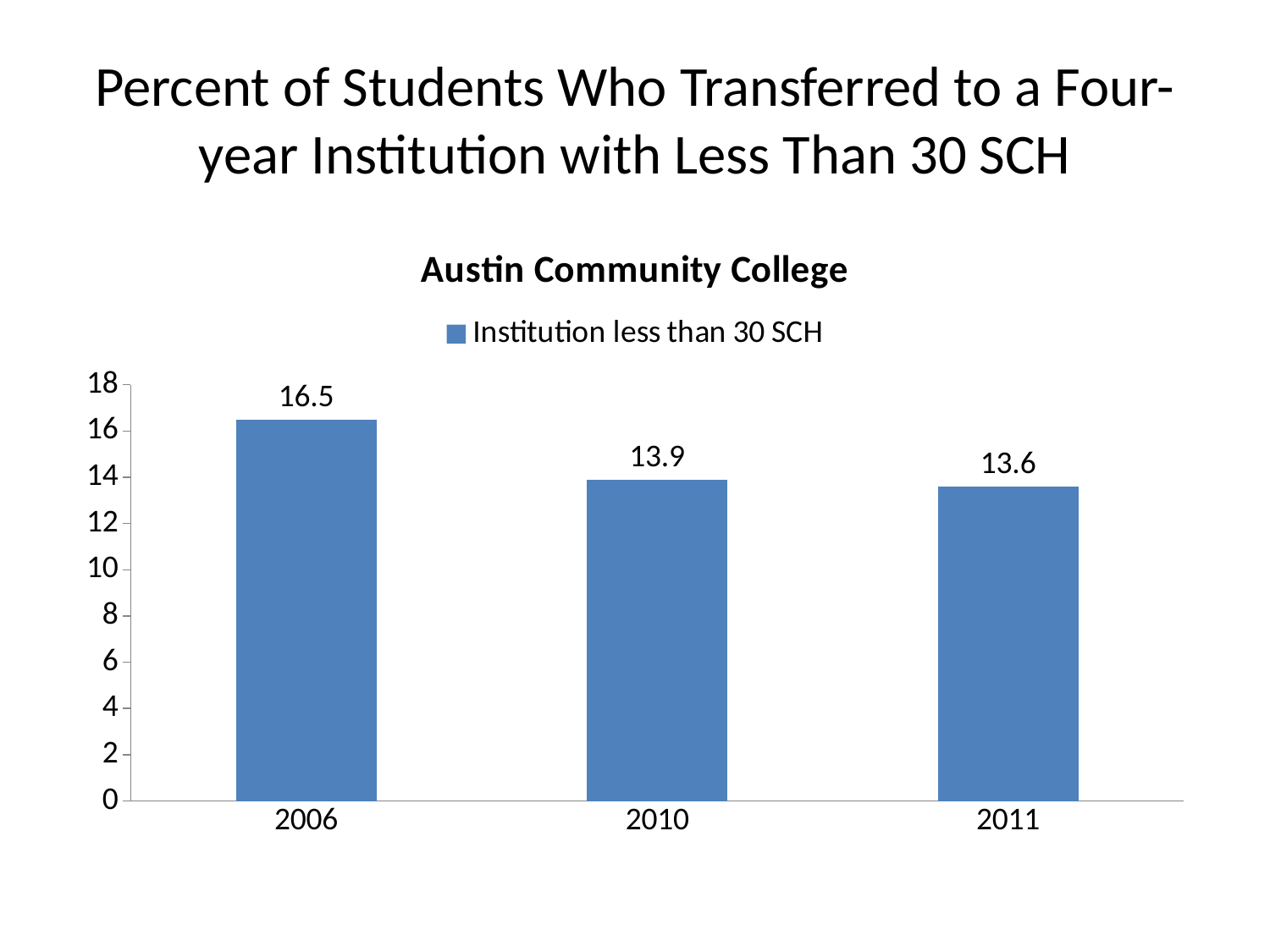
What is the value for 2006? 16.5 What is the value for 2011? 13.6 Which year has the lowest value? 2011 Do the values rise or fall from 2006 to 2011? fall Is the value for 2010 greater or less than 14? less What is the difference between the values for 2010 and 2011? 0.3 What kind of chart is this? bar chart What is the value for 2010? 13.9 Which is larger, the value for 2006 or the value for 2010? 2006 What is the difference between the values for 2006 and 2011? 2.9 How many years are shown on the x axis? 3 Which year has the highest value? 2006